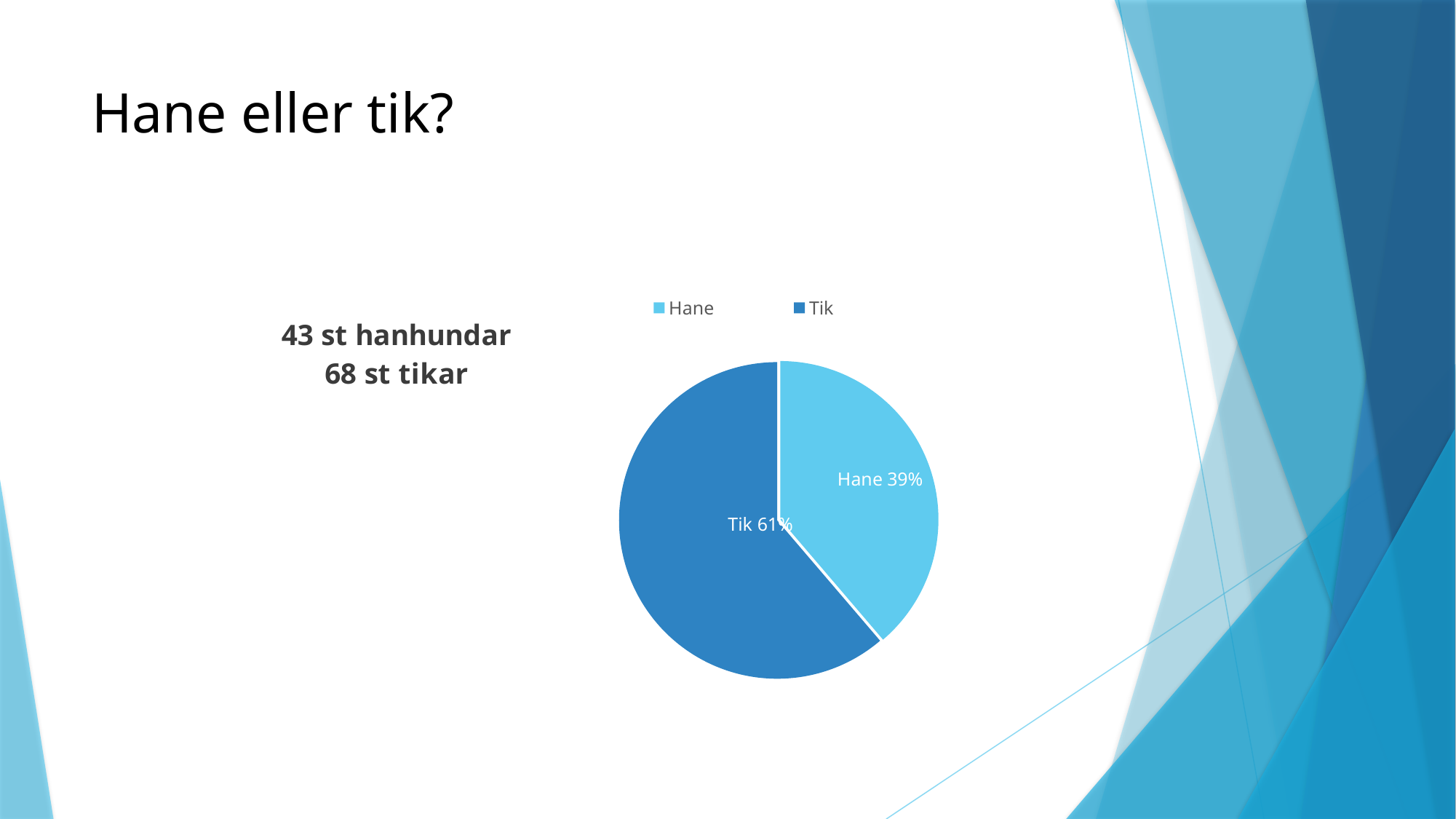
What are the two entries listed in the legend? Hane, Tik What share of the pie does the Tik slice represent? 61% Which is larger, the Hane slice or the Tik slice? Tik Is the share for Tik greater or less than 50%? greater How many slices does the pie chart have? 2 What is the difference in percentage points between the Tik slice and the Hane slice? 22 What kind of chart is shown on the slide? pie chart Which slice of the pie is the largest? Tik Which slice of the pie is the smallest? Hane How many entries does the legend list? 2 What share of the pie does the Hane slice represent? 39% Which slice is drawn in the darker blue colour? Tik